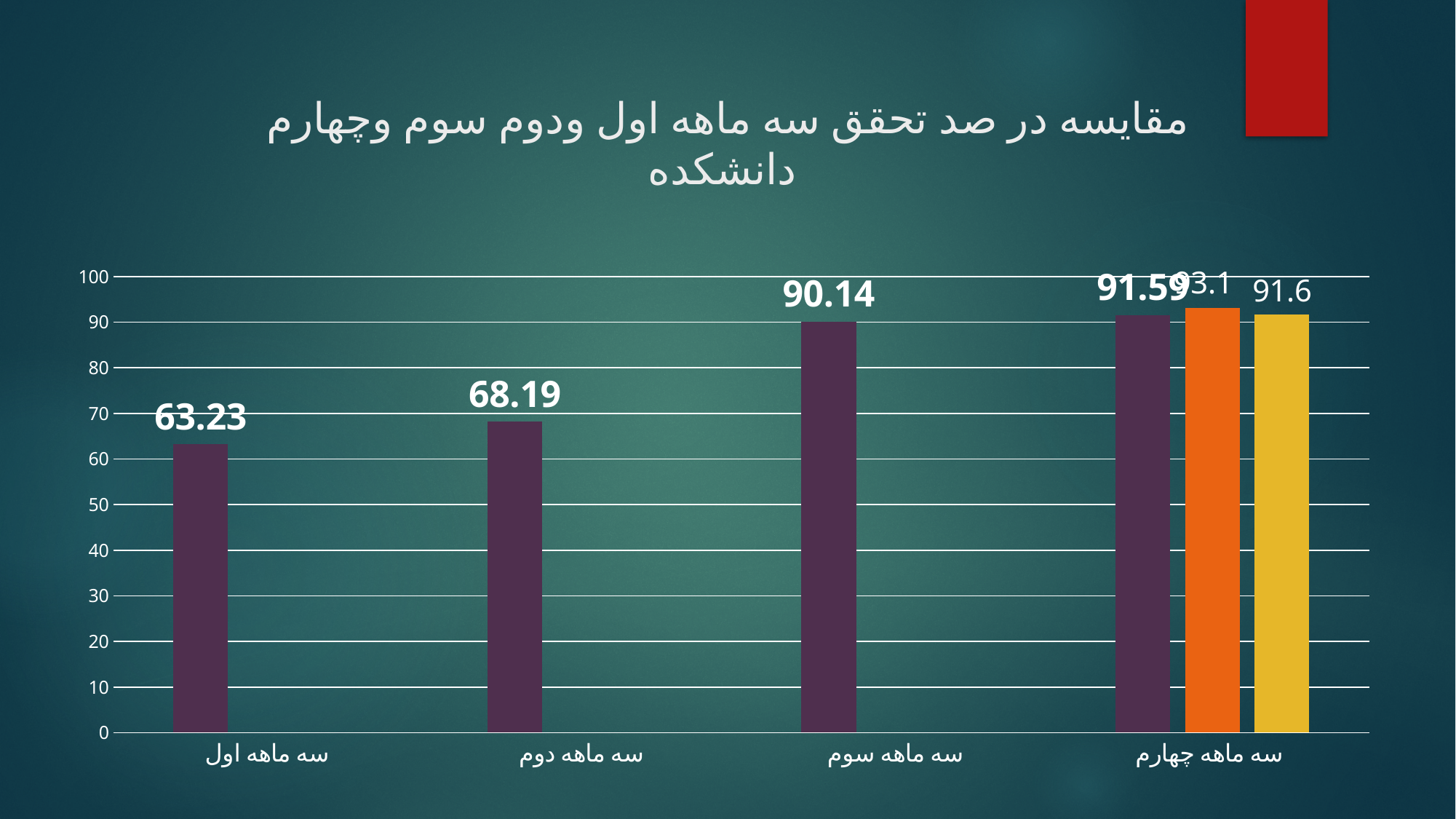
What is the value of the yellow bar for سه ماهه چهارم? 91.6 What kind of chart is shown on the slide? bar chart What is the value of the purple bar for سه ماهه چهارم? 91.59 What is the difference between the values for سه ماهه دوم and سه ماهه اول? 4.96 Do the purple bars rise or fall from سه ماهه اول to سه ماهه چهارم? rise What is the value shown for سه ماهه سوم? 90.14 Which category has the lowest value? سه ماهه اول How many categories are shown on the x axis? 4 Among the purple bars, which category has the highest value? سه ماهه چهارم What is the value shown for سه ماهه دوم? 68.19 What is the value shown for سه ماهه اول? 63.23 Which is larger, the value for سه ماهه سوم or the value for سه ماهه دوم? سه ماهه سوم